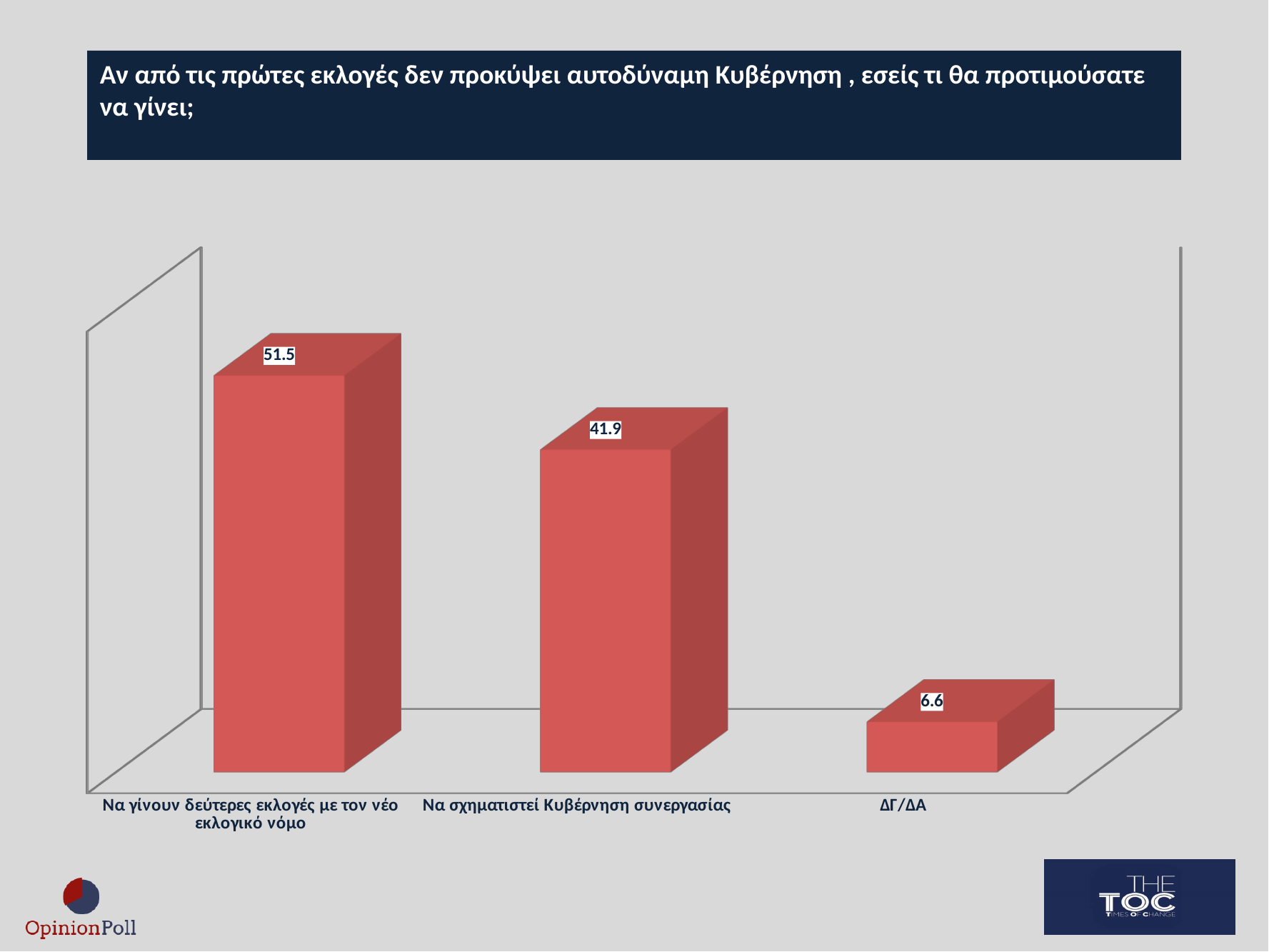
What is the difference between the values for "Να σχηματιστεί Κυβέρνηση συνεργασίας" and "ΔΓ/ΔΑ"? 35.3 Which category has the lowest value? ΔΓ/ΔΑ How many categories are shown in the chart? 3 Which is larger: the value for "Να σχηματιστεί Κυβέρνηση συνεργασίας" or the value for "ΔΓ/ΔΑ"? Να σχηματιστεί Κυβέρνηση συνεργασίας What is the title of the chart? Αν από τις πρώτες εκλογές δεν προκύψει αυτοδύναμη Κυβέρνηση , εσείς τι θα προτιμούσατε να γίνει; Which category has the highest value? Να γίνουν δεύτερες εκλογές με τον νέο εκλογικό νόμο What is the value for "ΔΓ/ΔΑ"? 6.6 Do the values rise or fall from left to right across the categories? Fall What is the difference between the values for "Να γίνουν δεύτερες εκλογές με τον νέο εκλογικό νόμο" and "Να σχηματιστεί Κυβέρνηση συνεργασίας"? 9.6 What is the value for "Να σχηματιστεί Κυβέρνηση συνεργασίας"? 41.9 What is the value for "Να γίνουν δεύτερες εκλογές με τον νέο εκλογικό νόμο"? 51.5 What kind of chart is shown on the slide? Bar chart